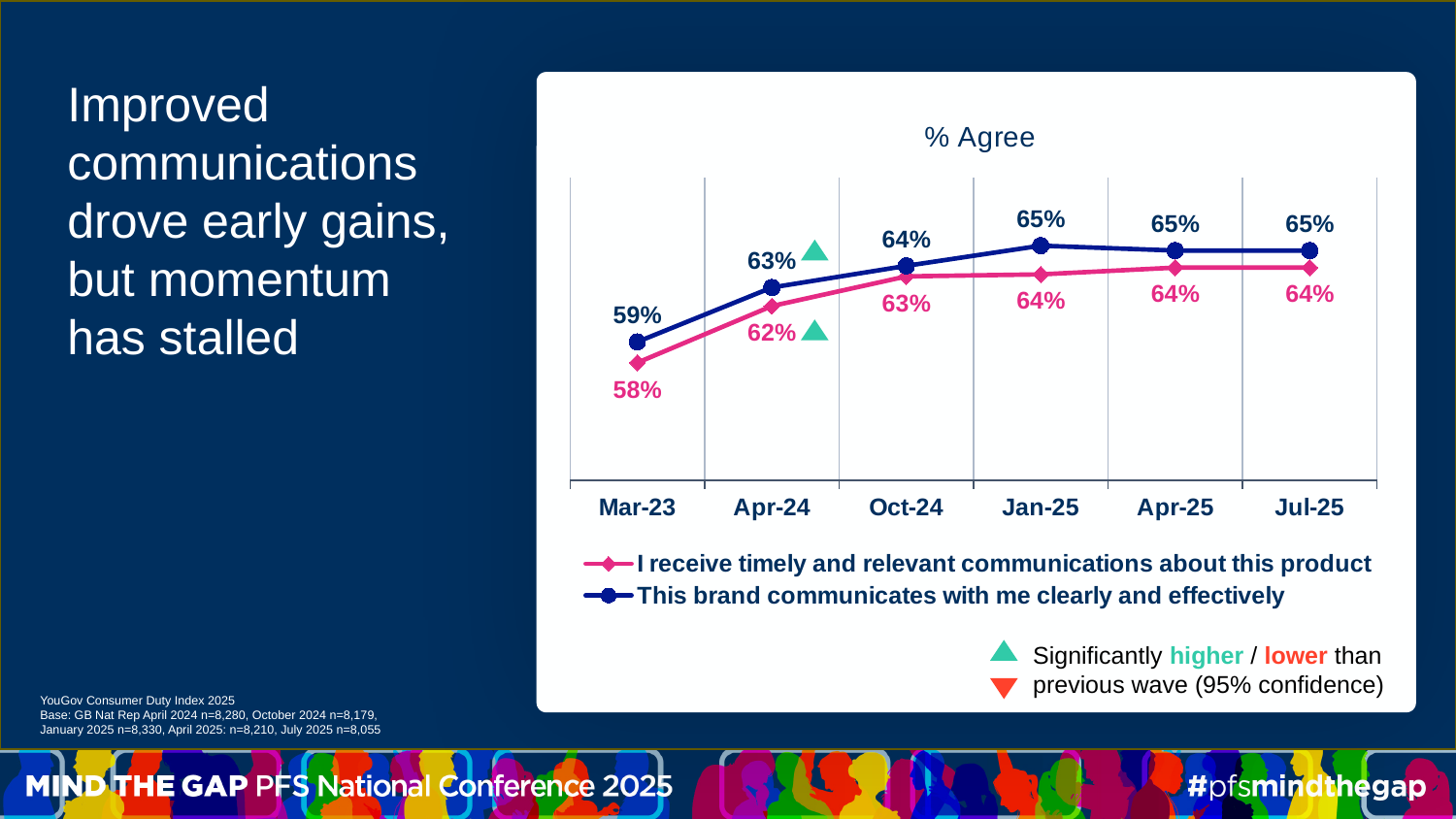
What is the difference between the two series in Mar-23? 1% Does 'This brand communicates with me clearly and effectively' rise or fall from Mar-23 to Jan-25? Rise In Oct-24, which series has the higher value? This brand communicates with me clearly and effectively What is the value for 'I receive timely and relevant communications about this product' in Jul-25? 64% What is the title of the chart? % Agree For 'This brand communicates with me clearly and effectively', what is the difference between Jan-25 and Mar-23? 6% What is the value for 'This brand communicates with me clearly and effectively' in Mar-23? 59% How many series does the legend list? 2 At which time point is 'I receive timely and relevant communications about this product' lowest? Mar-23 What type of chart is shown on the slide? Line chart What is the value for 'I receive timely and relevant communications about this product' in Apr-24? 62% How many time points are shown on the x axis? 6